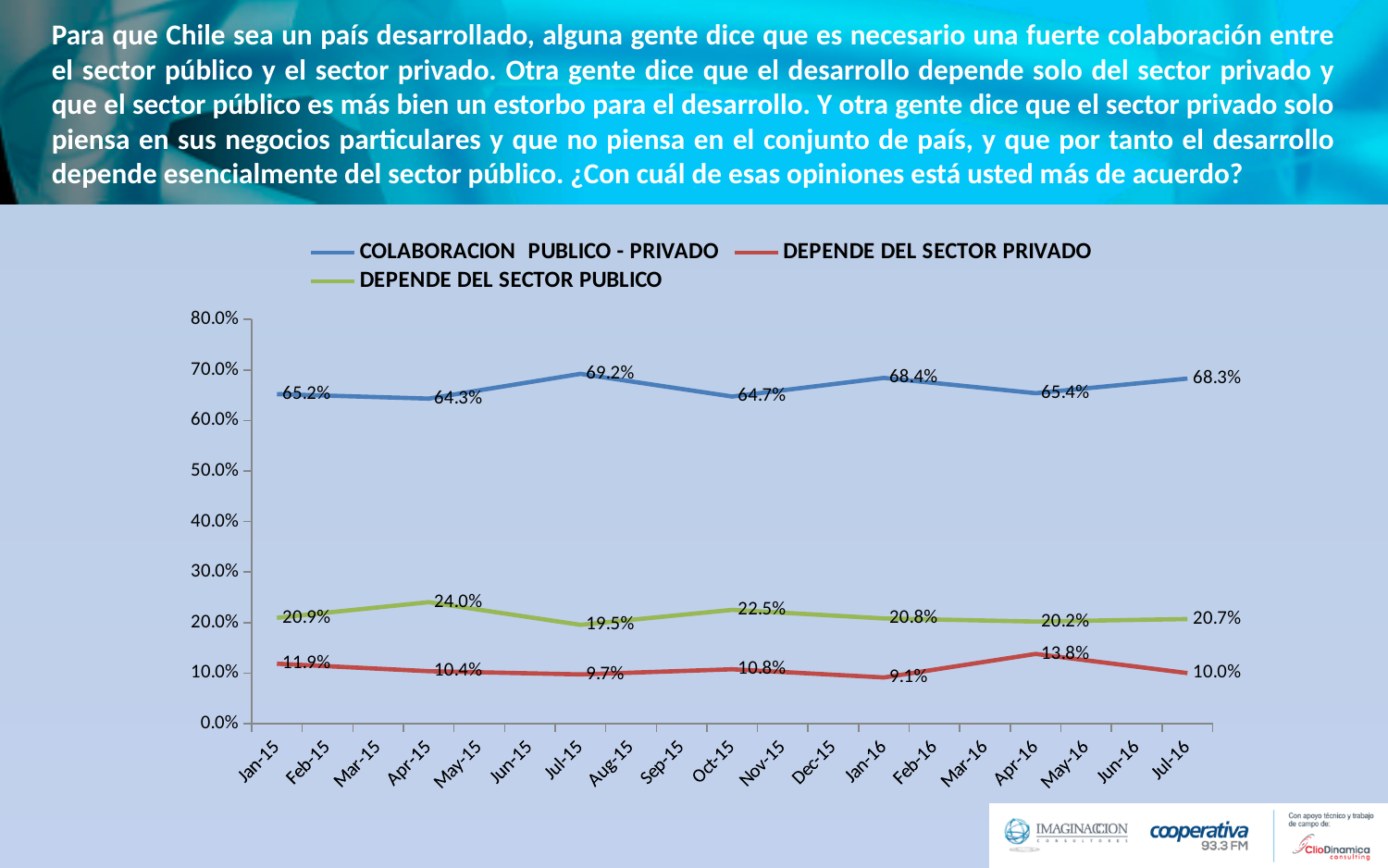
How many series does the legend list? 3 In which month does the DEPENDE DEL SECTOR PRIVADO series reach its lowest value? Jan-16 What colour is the line for DEPENDE DEL SECTOR PRIVADO? Red In which month does the COLABORACION PUBLICO - PRIVADO series reach its highest value? Jul-15 How many data points are plotted for the DEPENDE DEL SECTOR PUBLICO series? 7 What is the value for DEPENDE DEL SECTOR PUBLICO in Apr-15? 24.0% What is the value for COLABORACION PUBLICO - PRIVADO in Jul-15? 69.2% Is the value for COLABORACION PUBLICO - PRIVADO in Jan-16 greater or less than 60.0%? greater Which is larger in Oct-15: DEPENDE DEL SECTOR PUBLICO or DEPENDE DEL SECTOR PRIVADO? DEPENDE DEL SECTOR PUBLICO What kind of chart is shown on the slide? Line chart What is the value for DEPENDE DEL SECTOR PRIVADO in Apr-16? 13.8% What is the difference between the COLABORACION PUBLICO - PRIVADO values in Jul-15 and Apr-15? 4.9%